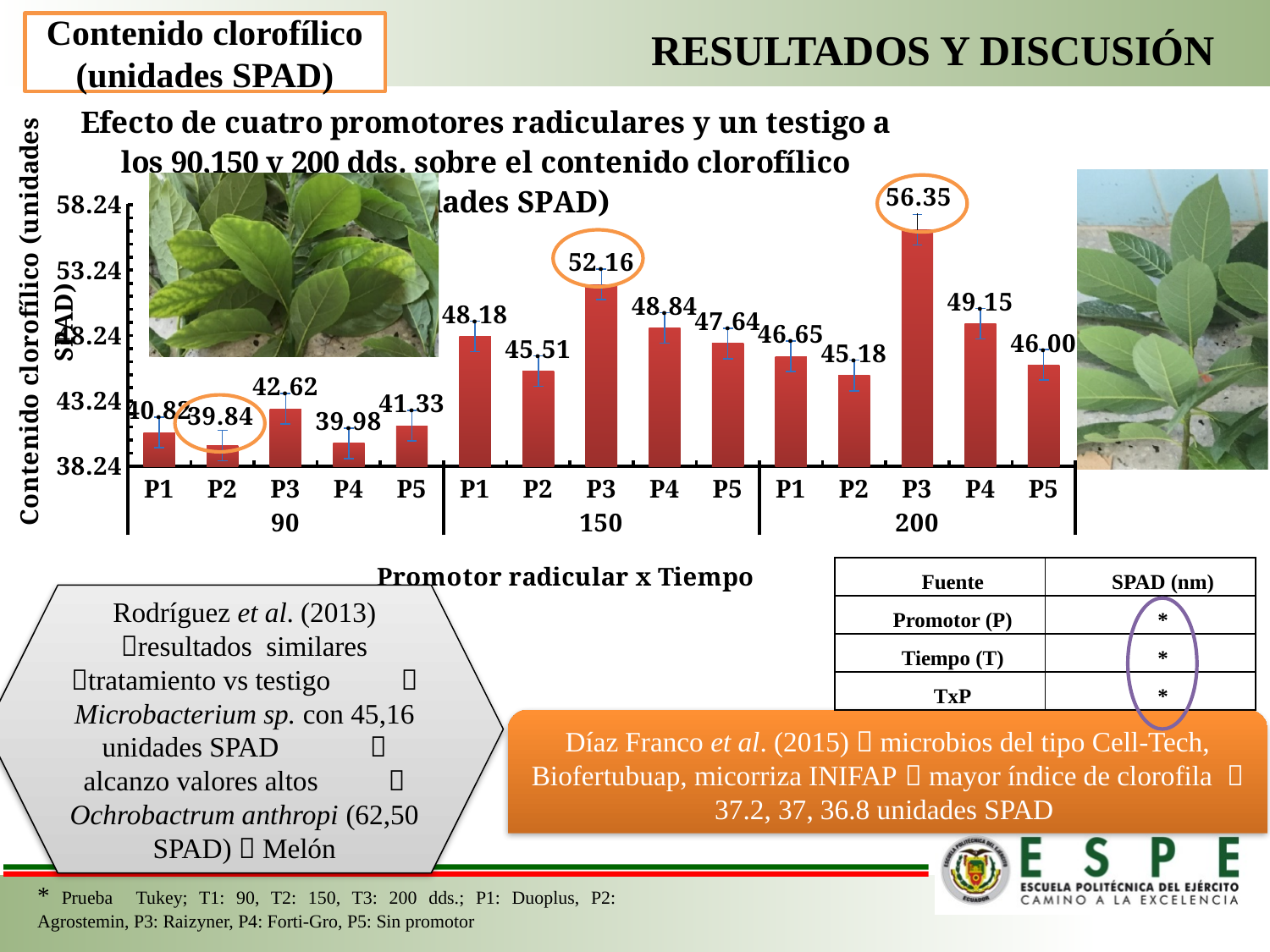
What is the value for P5 at 200 dds? 46.00 How many bars are plotted in the chart? 15 What type of chart is shown on the slide? bar chart What is the x-axis title of the chart? Promotor radicular x Tiempo What is the difference between the values for P3 and P2 at 150 dds? 6.65 Within the 90 dds group, which promoter has the highest value? P3 What is the value for P2 at 90 dds? 39.84 What is the value for P3 at 150 dds? 52.16 Which is larger, the value for P4 at 150 dds or the value for P4 at 200 dds? P4 at 200 dds Which bar has the highest value in the chart? P3 at 200 Which bar has the lowest value in the chart? P2 at 90 What is the value for P3 at 200 dds? 56.35